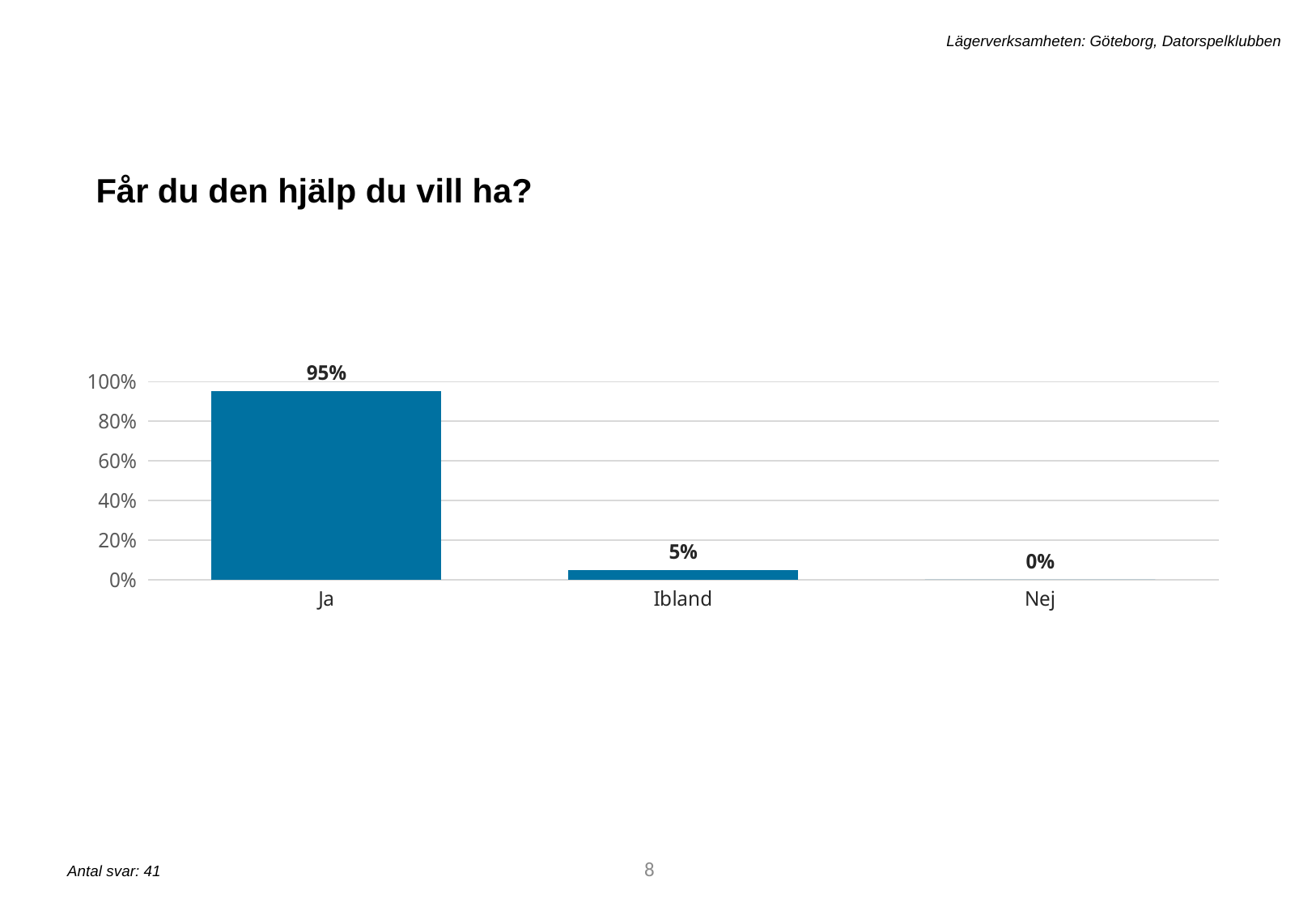
What is the value for Ibland? 5% Which category has the highest value? Ja What is the difference between the values for Ja and Ibland? 90% Which category has the lowest value? Nej What is the title of the chart? Får du den hjälp du vill ha? Which is larger, the value for Ibland or the value for Nej? Ibland What kind of chart is shown on the slide? bar chart Is the value for Ja greater or less than 80%? greater What is the value for Ja? 95% How many categories are shown on the x axis? 3 Do the values rise or fall from left to right along the x axis? fall What is the value for Nej? 0%